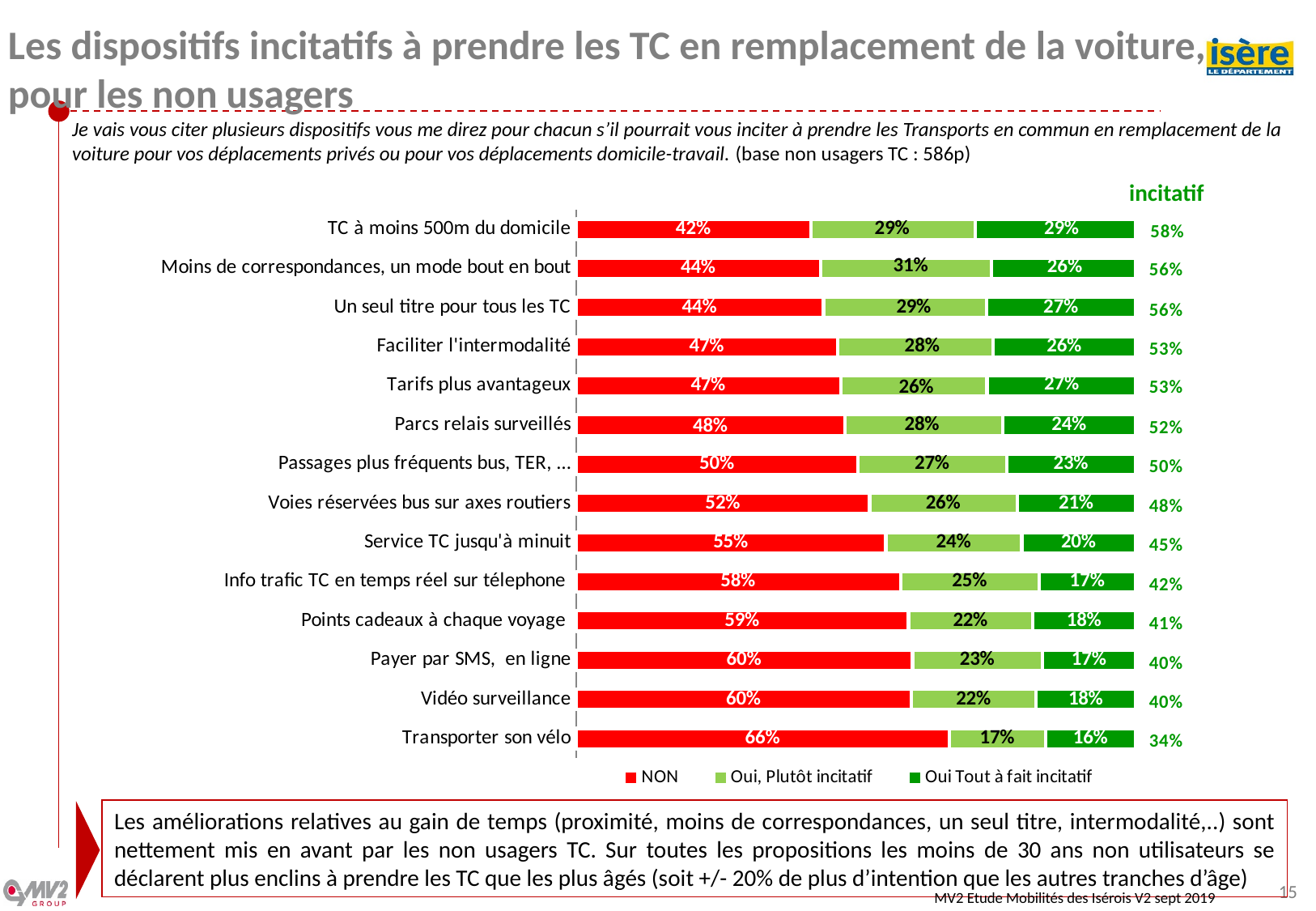
Which category has the highest NON percentage? Transporter son vélo What is the total "incitatif" share (Plutôt + Tout à fait) for "Faciliter l'intermodalité"? 53% How many categories (dispositifs) are shown in the chart? 14 What is the "Oui, Plutôt incitatif" value for "Moins de correspondances, un mode bout en bout"? 31% What is the "Oui Tout à fait incitatif" value for "TC à moins 500m du domicile"? 29% What percentage of non-users answered NON for "Transporter son vélo"? 66% What is the difference between the NON value for "Service TC jusqu'à minuit" and the NON value for "Parcs relais surveillés"? 7% Which series is shown in red in the legend? NON What kind of chart is shown on the slide? Stacked bar chart Which has a larger "Oui Tout à fait incitatif" value: "Tarifs plus avantageux" or "Voies réservées bus sur axes routiers"? Tarifs plus avantageux How many series does the legend list? 3 Which category has the lowest NON percentage? TC à moins 500m du domicile